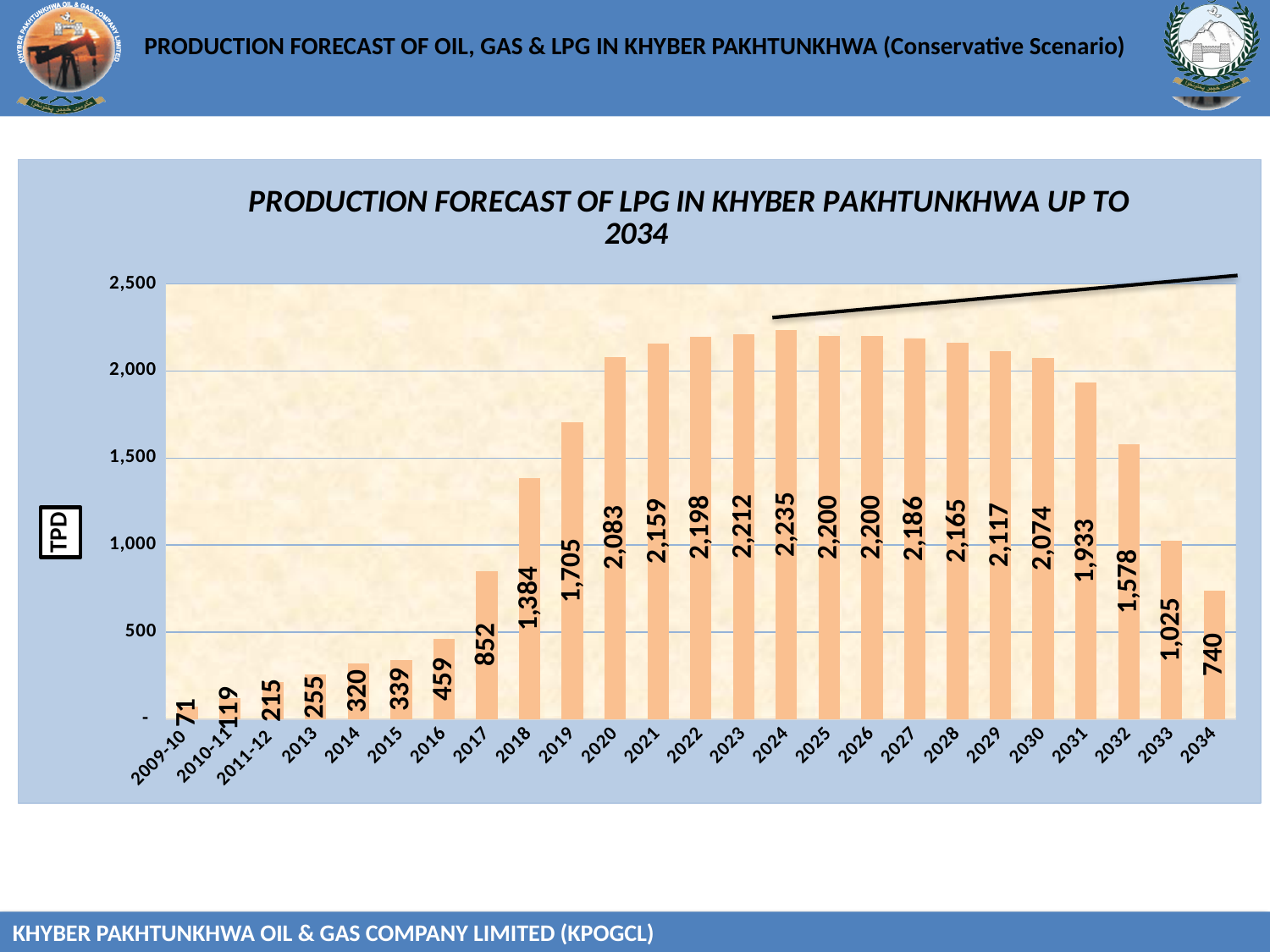
Is the value for 2017 greater or less than 1,000? less What is the difference between the values for 2019 and 2018? 321 What is the value shown for 2034? 740 What is the value shown for 2018? 1,384 What kind of chart is this? bar chart What is the difference between the values for 2024 and 2034? 1,495 Which category has the lowest value? 2009-10 What is the LPG production forecast value for 2024? 2,235 How many categories are shown on the x axis? 25 Which year has the highest forecast value? 2024 Which is larger, the value for 2031 or the value for 2032? 2031 What is the label on the y axis? TPD